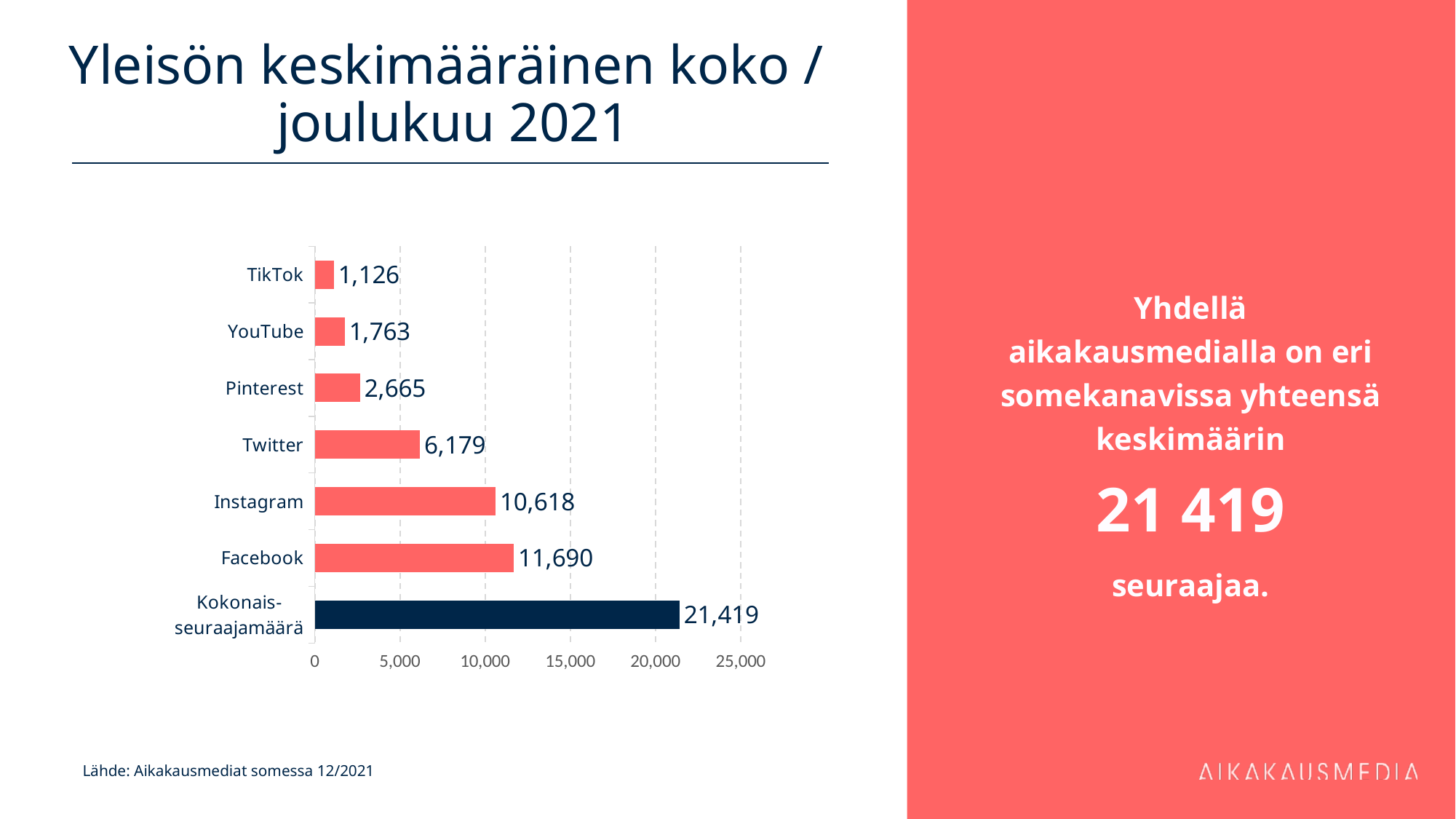
What is the difference between the values for Twitter and Pinterest? 3,514 What is the difference between the values for Facebook and Instagram? 1,072 What is the value for Facebook? 11,690 Which social media channel (excluding the total bar) has the highest value? Facebook What is the value for Instagram? 10,618 Which category has the lowest value? TikTok What is the value for TikTok? 1,126 How many categories are shown in the chart? 7 What is the value for Kokonais-seuraajamäärä? 21,419 What kind of chart is shown on the slide? bar chart Which is larger, the value for YouTube or the value for Pinterest? Pinterest Is the value for Twitter greater or less than 5,000? greater